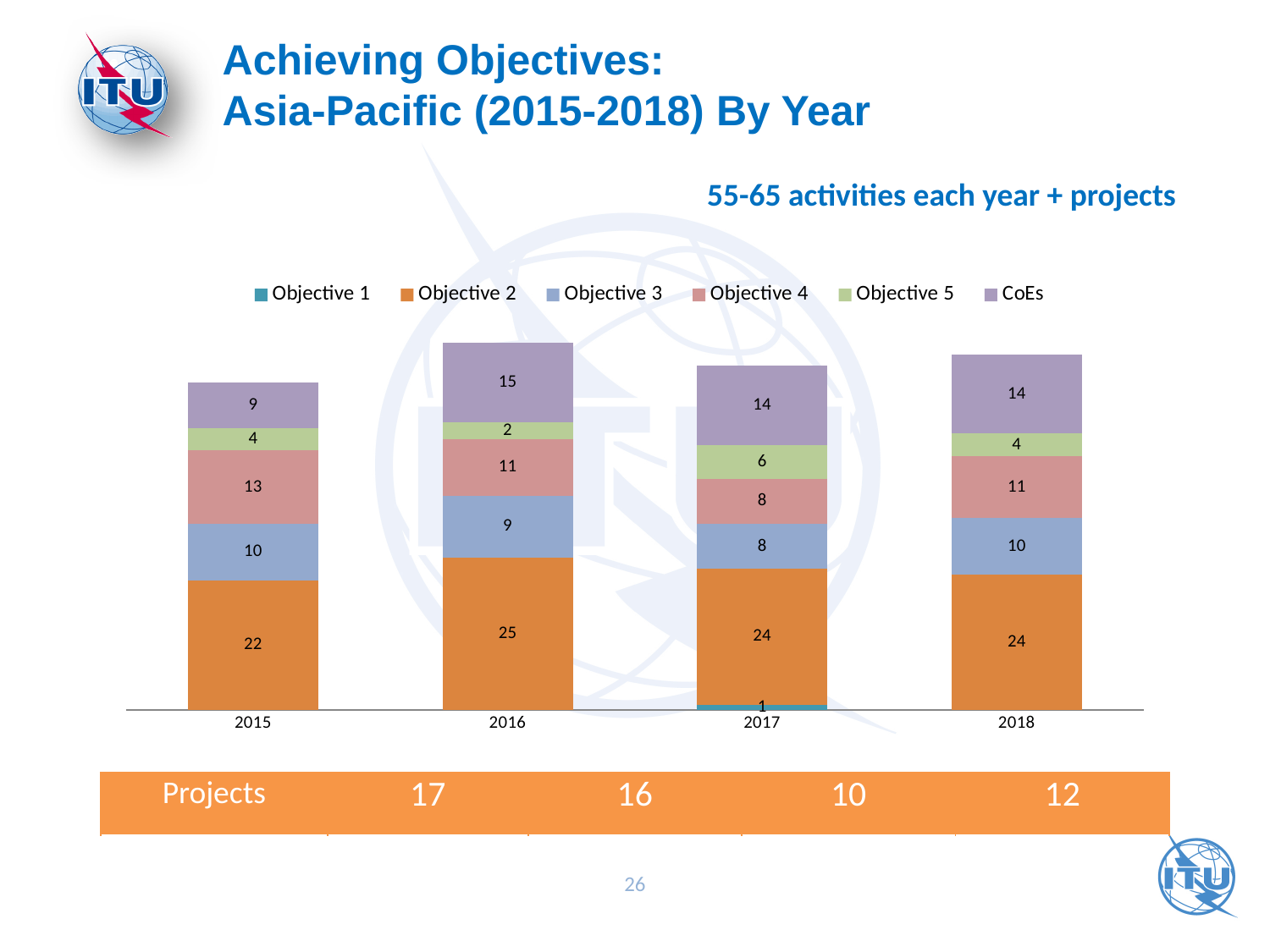
What is the value for Objective 1 in 2017? 1 In which year is the Objective 5 value lowest? 2016 Which year has the larger Objective 4 value, 2015 or 2018? 2015 What is the value for Objective 5 in 2016? 2 What is the difference between the CoEs value in 2016 and in 2015? 6 How many years are shown on the x axis of the chart? 4 What is the value for CoEs in 2017? 14 In which year is the Objective 2 value highest? 2016 What kind of chart is shown on the slide? Stacked bar chart How many series does the chart legend list? 6 What is the total of the stacked bar for 2015? 58 What is the value for Objective 2 in 2016? 25